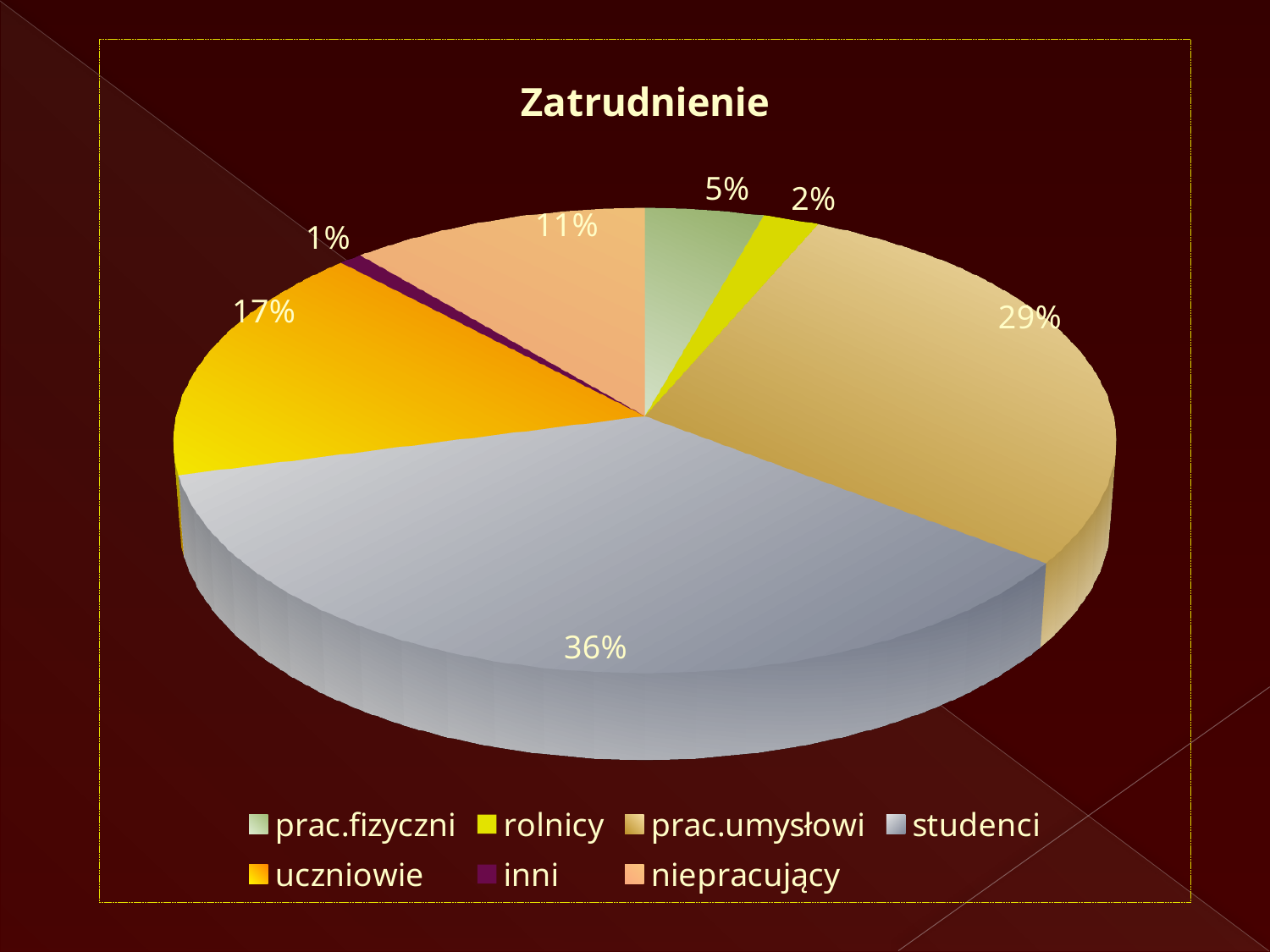
What share of the pie does studenci have? 36% What is the difference between the shares of studenci and prac.umysłowi? 7% Which category has the smallest share of the pie? inni What share of the pie does inni have? 1% What share of the pie does prac.umysłowi have? 29% What share of the pie does niepracujący have? 11% What kind of chart is shown on the slide? pie chart What share of the pie does uczniowie have? 17% Which category has the largest share of the pie? studenci What is the title of the chart? Zatrudnienie Which has a larger share, prac.fizyczni or rolnicy? prac.fizyczni How many categories does the legend list? 7